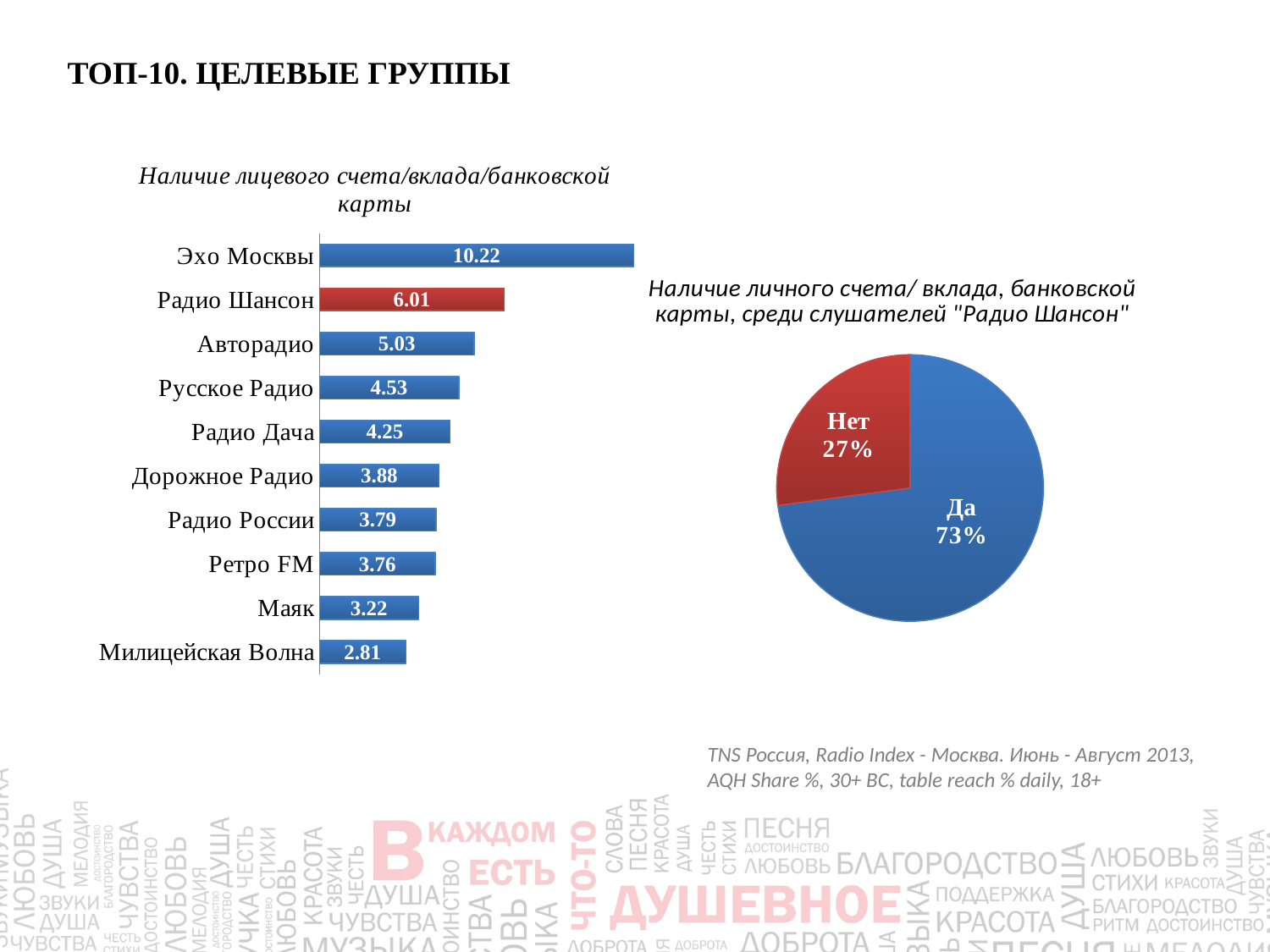
How many stations are shown in the bar chart "Наличие лицевого счета/вклада/банковской карты"? 10 In the bar chart "Наличие лицевого счета/вклада/банковской карты", which bar is coloured red instead of blue? Радио Шансон In the pie chart on the right, what share of Радио Шансон listeners answered "Нет"? 27% In the bar chart "Наличие лицевого счета/вклада/банковской карты", which station has the lowest value? Милицейская Волна In the bar chart "Наличие лицевого счета/вклада/банковской карты", which station has the highest value? Эхо Москвы In the bar chart "Наличие лицевого счета/вклада/банковской карты", what is the value for Радио Шансон? 6.01 What kind of chart is the chart on the left titled "Наличие лицевого счета/вклада/банковской карты"? Bar chart What kind of chart is the chart on the right of the slide? Pie chart In the bar chart "Наличие лицевого счета/вклада/банковской карты", which is larger: the value for Авторадио or the value for Русское Радио? Авторадио In the bar chart "Наличие лицевого счета/вклада/банковской карты", what is the difference between the values for Эхо Москвы and Радио Шансон? 4.21 In the bar chart "Наличие лицевого счета/вклада/банковской карты", what is the value for Радио Дача? 4.25 In the pie chart on the right, what share of Радио Шансон listeners answered "Да"? 73%